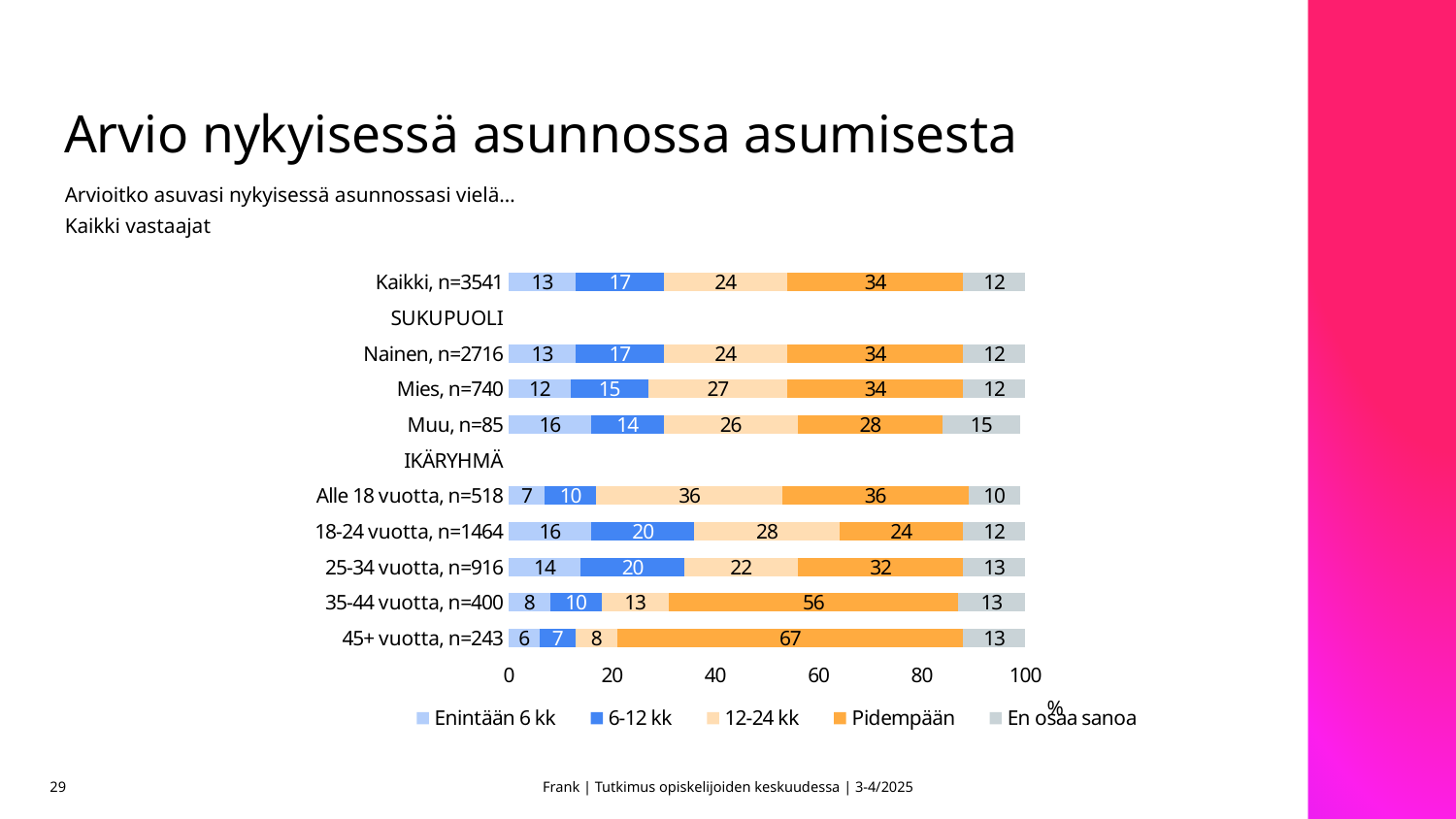
What kind of chart is shown on the slide? Stacked bar chart What is the value of "En osaa sanoa" for "Muu, n=85"? 15 Which group has the highest value for "Pidempään"? 45+ vuotta, n=243 Which group has the lowest value for "Enintään 6 kk"? 45+ vuotta, n=243 What is the value of "12-24 kk" for "Alle 18 vuotta, n=518"? 36 Which is larger: the "6-12 kk" value for "18-24 vuotta, n=1464" or for "Mies, n=740"? 18-24 vuotta, n=1464 What is the value of "Pidempään" for "45+ vuotta, n=243"? 67 What is the value of "Pidempään" for "Kaikki, n=3541"? 34 What is the total of the stacked bar for "Mies, n=740"? 100 What is the difference between the "Pidempään" values for "35-44 vuotta, n=400" and "25-34 vuotta, n=916"? 24 What is the value of "Enintään 6 kk" for "Muu, n=85"? 16 How many series does the legend list? 5